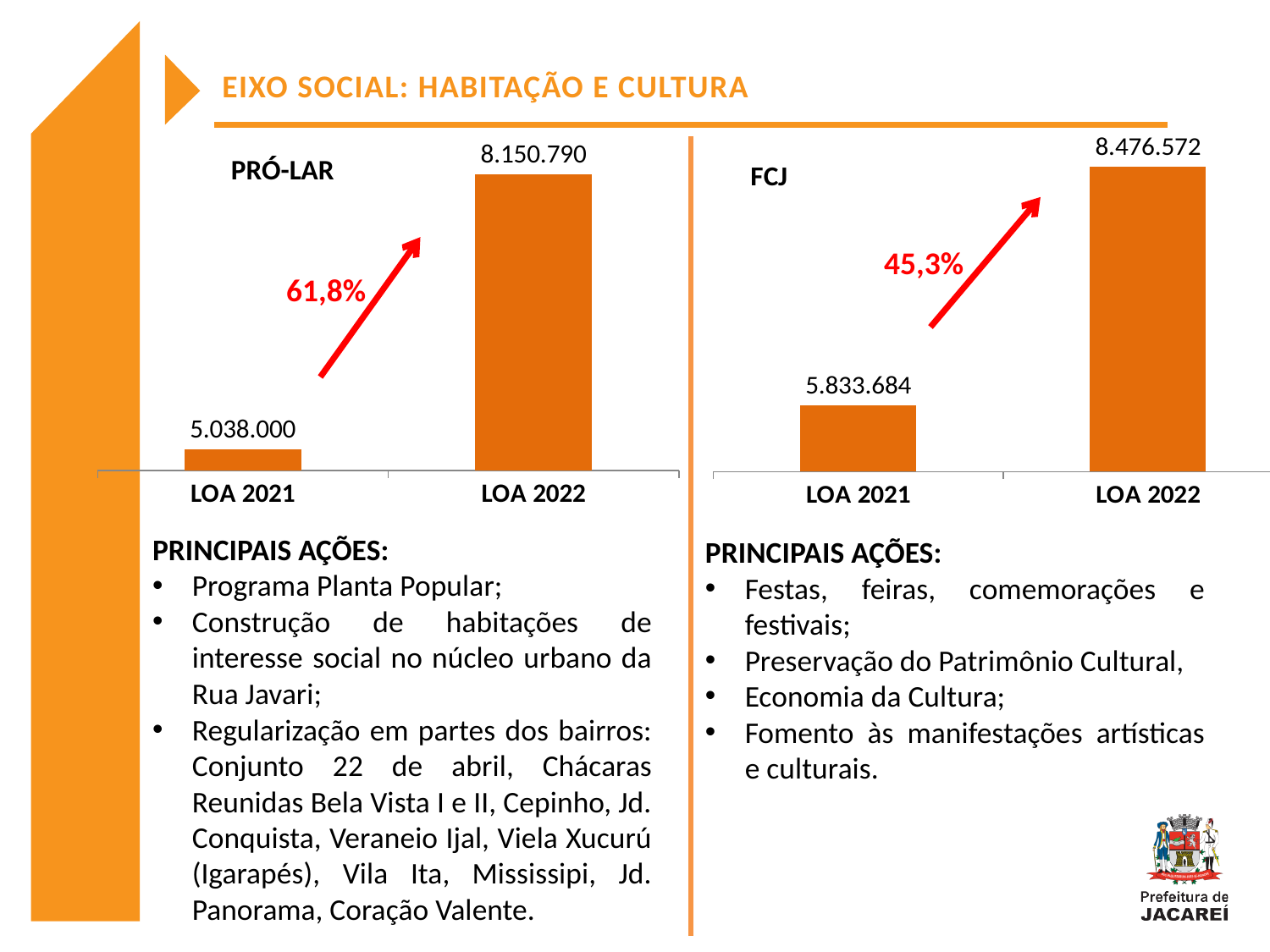
In the FCJ chart, what is the difference between the LOA 2022 and LOA 2021 values? 2.642.888 What type of chart is the PRÓ-LAR chart? Bar chart Which is larger: the LOA 2022 value in the PRÓ-LAR chart or the LOA 2022 value in the FCJ chart? FCJ LOA 2022 In the PRÓ-LAR chart, what is the difference between the LOA 2022 and LOA 2021 values? 3.112.790 In the FCJ chart, which category has the lowest value? LOA 2021 In the PRÓ-LAR chart, which category has the highest value? LOA 2022 In the FCJ chart, do the values rise or fall from LOA 2021 to LOA 2022? Rise In the FCJ chart, what is the value for LOA 2022? 8.476.572 What percentage increase is annotated on the PRÓ-LAR chart? 61,8% In the PRÓ-LAR chart, what is the value for LOA 2022? 8.150.790 In the PRÓ-LAR chart, what is the value for LOA 2021? 5.038.000 In the FCJ chart, what is the value for LOA 2021? 5.833.684